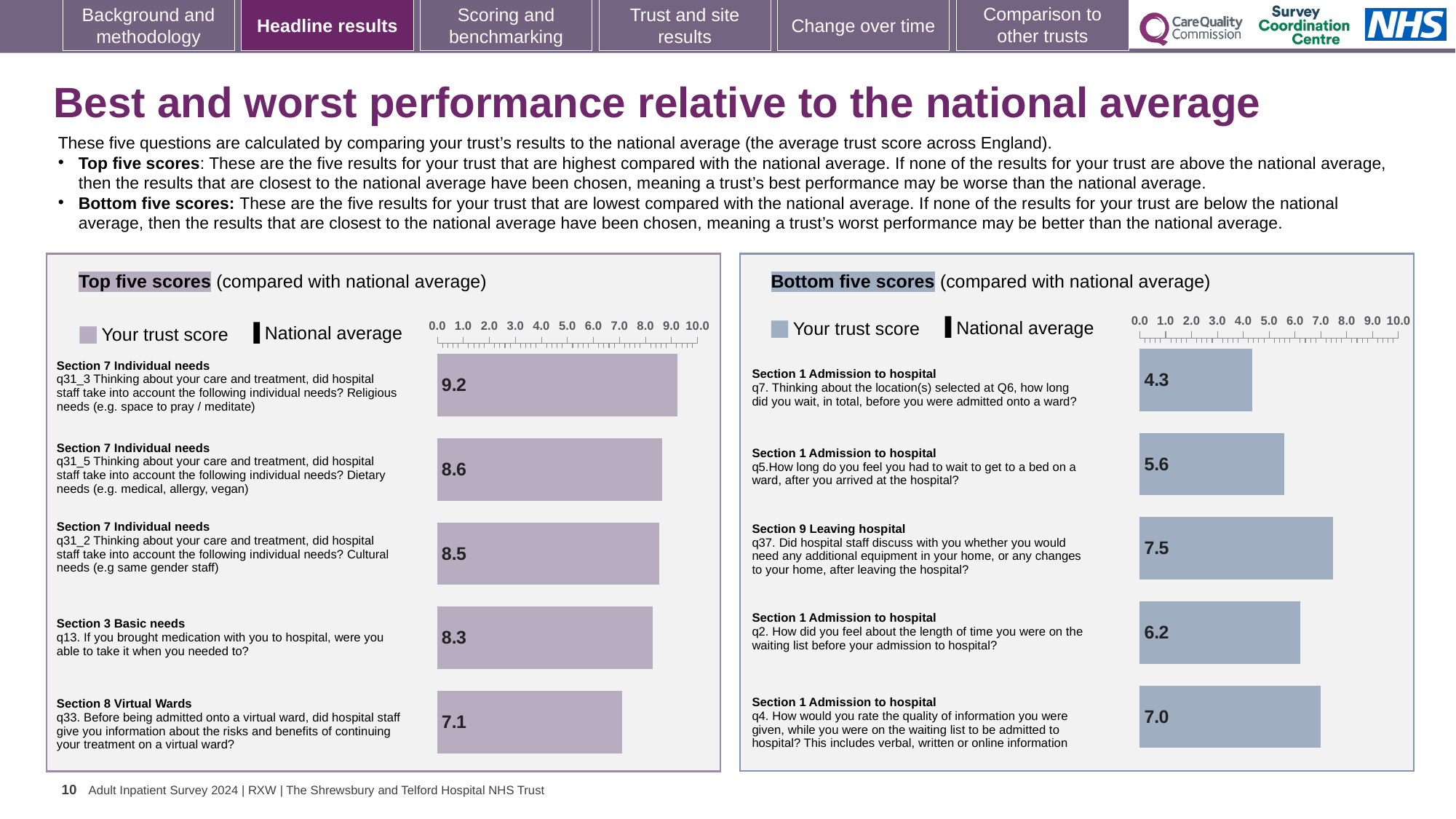
In the Bottom five scores chart, which question has the highest trust score? q37 (7.5) In the Bottom five scores chart, which has the larger trust score: q37 or q4? q37 (7.5) In the Bottom five scores chart, which question has the lowest trust score? q7 (4.3) In the Bottom five scores chart, what is the trust score for q7 (how long did you wait, in total, before you were admitted onto a ward?)? 4.3 In the Bottom five scores chart, what is the difference between the score for q37 and the score for q7? 3.2 In the Top five scores chart, what is the trust score for q13 (If you brought medication with you to hospital, were you able to take it when you needed to?)? 8.3 In the Top five scores chart, what is the difference between the highest score (9.2) and the lowest score (7.1)? 2.1 In the Top five scores chart, what is the trust score for q31_5 (Dietary needs)? 8.6 How many bars are shown in the Top five scores chart? 5 In the Top five scores chart, which question has the highest trust score? q31_3 Religious needs (9.2) In the Bottom five scores chart, is the trust score for q5 greater or less than 5.0? greater What type of chart is used for the Bottom five scores? Bar chart